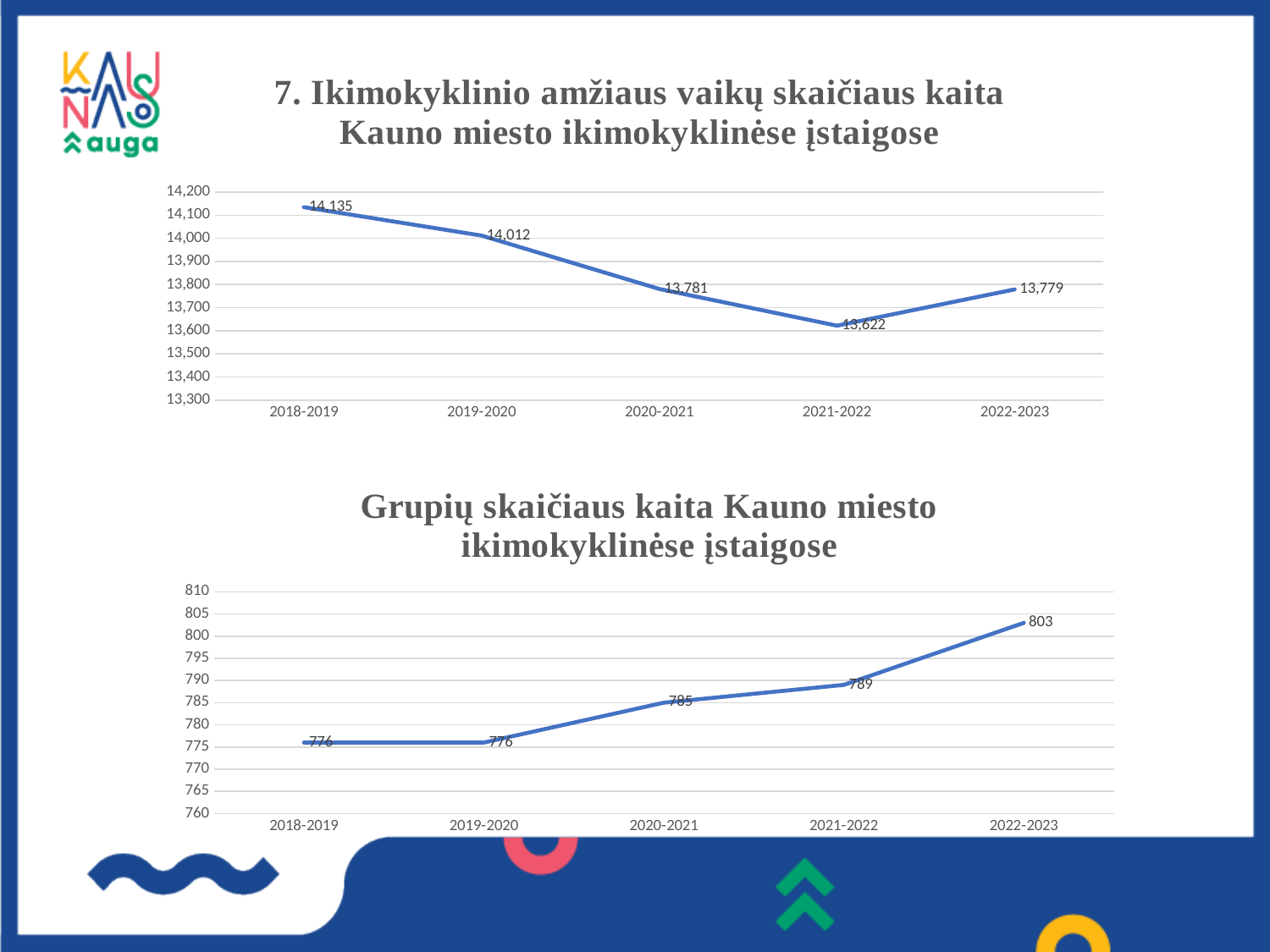
In the bottom chart (Grupių skaičiaus kaita), what is the difference between the values for 2022-2023 and 2018-2019? 27 In the top chart (Ikimokyklinio amžiaus vaikų skaičiaus kaita), which school year has the highest value? 2018-2019 In the top chart (Ikimokyklinio amžiaus vaikų skaičiaus kaita), which school year has the lowest value? 2021-2022 In the top chart (Ikimokyklinio amžiaus vaikų skaičiaus kaita), is the value for 2020-2021 larger or smaller than the value for 2022-2023? larger In the top chart (Ikimokyklinio amžiaus vaikų skaičiaus kaita), what is the value for 2021-2022? 13,622 In the bottom chart (Grupių skaičiaus kaita), do the values generally rise or fall from 2018-2019 to 2022-2023? rise In the top chart (Ikimokyklinio amžiaus vaikų skaičiaus kaita), what is the difference between the values for 2018-2019 and 2021-2022? 513 In the bottom chart (Grupių skaičiaus kaita), what is the value for 2022-2023? 803 In the bottom chart (Grupių skaičiaus kaita), what is the value for 2020-2021? 785 How many data points are plotted in the bottom chart (Grupių skaičiaus kaita)? 5 What type of chart is the top chart (Ikimokyklinio amžiaus vaikų skaičiaus kaita)? line chart In the top chart (Ikimokyklinio amžiaus vaikų skaičiaus kaita), what is the value for 2018-2019? 14,135